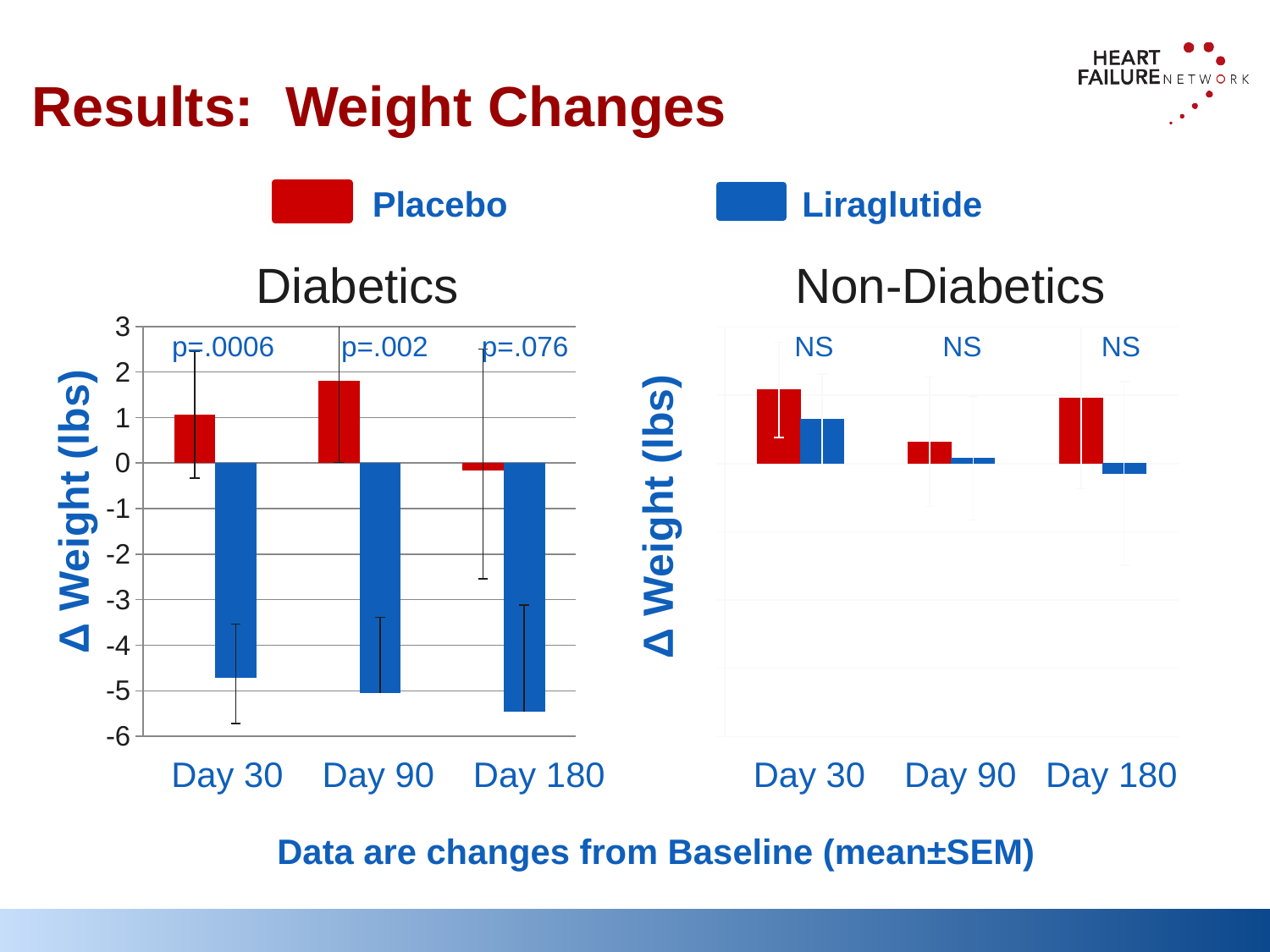
In the Diabetics chart, which is larger for Placebo: Day 30 or Day 90? Day 90 What kind of chart is the Diabetics chart? bar chart In the Diabetics chart, is the Liraglutide value at Day 30 greater or less than -4? less In the Diabetics chart, at which day is the Liraglutide value lowest? Day 180 In the Non-Diabetics chart, which is larger at Day 30: Placebo or Liraglutide? Placebo In the Diabetics chart, is the Liraglutide value at Day 180 greater or less than -5? less In the Diabetics chart, is the Placebo value at Day 90 greater or less than 1? greater In the Diabetics chart, at which day is the Placebo value highest? Day 90 What p-value is printed above Day 30 in the Diabetics chart? p=.0006 How many categories are shown on the x axis of the Diabetics chart? 3 In the Diabetics chart, do the Liraglutide values rise or fall from Day 30 to Day 180? fall How many series does the legend list? 2